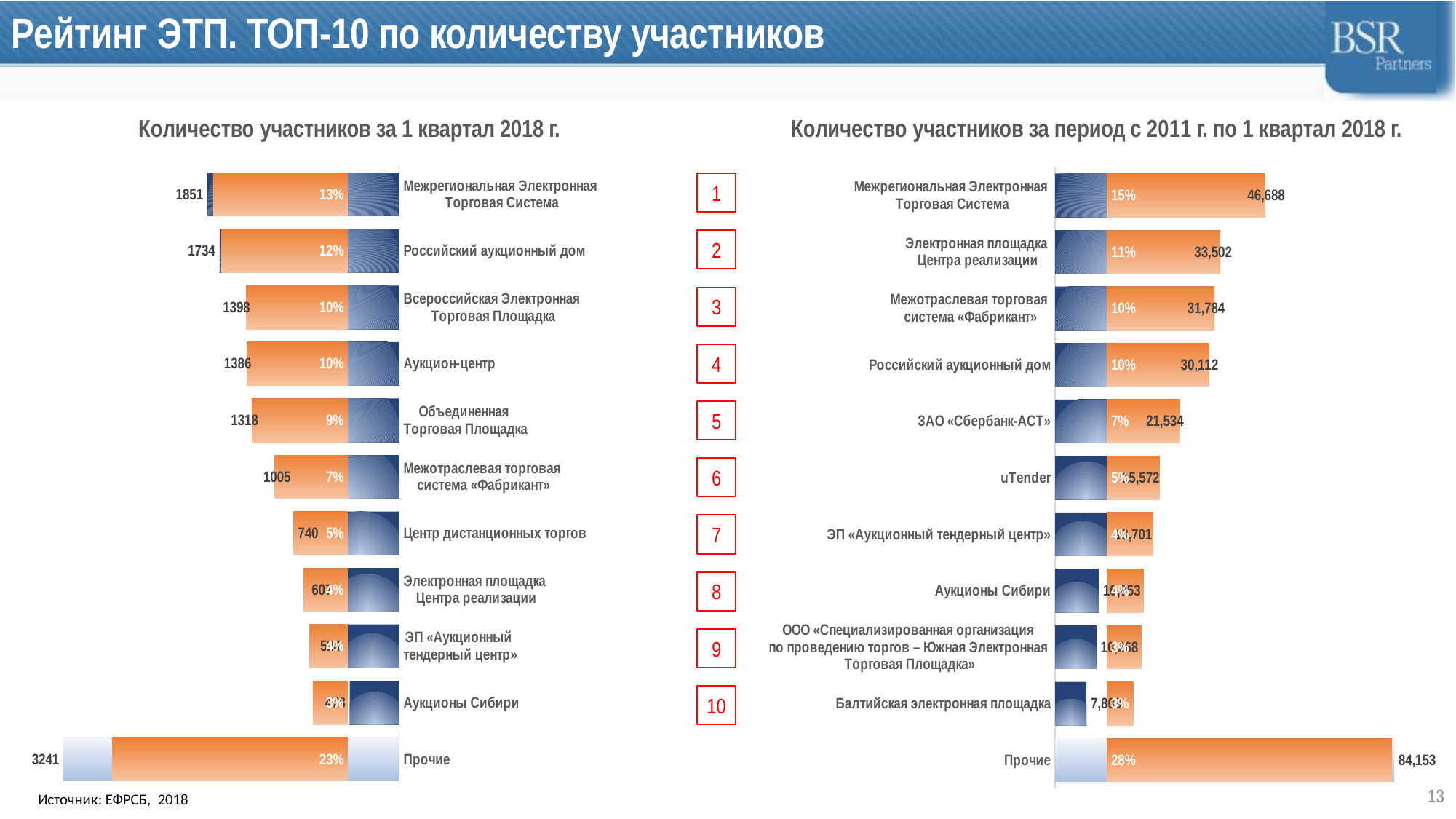
In the chart 'Количество участников за период с 2011 г. по 1 квартал 2018 г.', which is larger: Электронная площадка Центра реализации or Межотраслевая торговая система «Фабрикант»? Электронная площадка Центра реализации In the chart 'Количество участников за период с 2011 г. по 1 квартал 2018 г.', what is the difference between Межрегиональная Электронная Торговая Система and Российский аукционный дом? 16,576 In the chart 'Количество участников за 1 квартал 2018 г.', what is the value for Российский аукционный дом? 1734 In the chart 'Количество участников за период с 2011 г. по 1 квартал 2018 г.', what is the value for Межрегиональная Электронная Торговая Система? 46,688 What kind of chart is 'Количество участников за 1 квартал 2018 г.'? Bar chart In the chart 'Количество участников за 1 квартал 2018 г.', what is the value for Межрегиональная Электронная Торговая Система? 1851 How many categories are shown in the chart 'Количество участников за период с 2011 г. по 1 квартал 2018 г.'? 11 In the chart 'Количество участников за 1 квартал 2018 г.', what percentage is shown for Объединенная Торговая Площадка? 9% In the chart 'Количество участников за 1 квартал 2018 г.', which category has the highest value? Прочие In the chart 'Количество участников за период с 2011 г. по 1 квартал 2018 г.', what percentage is shown for Прочие? 28% In the chart 'Количество участников за 1 квартал 2018 г.', what is the difference between Всероссийская Электронная Торговая Площадка and Аукцион-центр? 12 In the chart 'Количество участников за период с 2011 г. по 1 квартал 2018 г.', what is the value for ЗАО «Сбербанк-АСТ»? 21,534